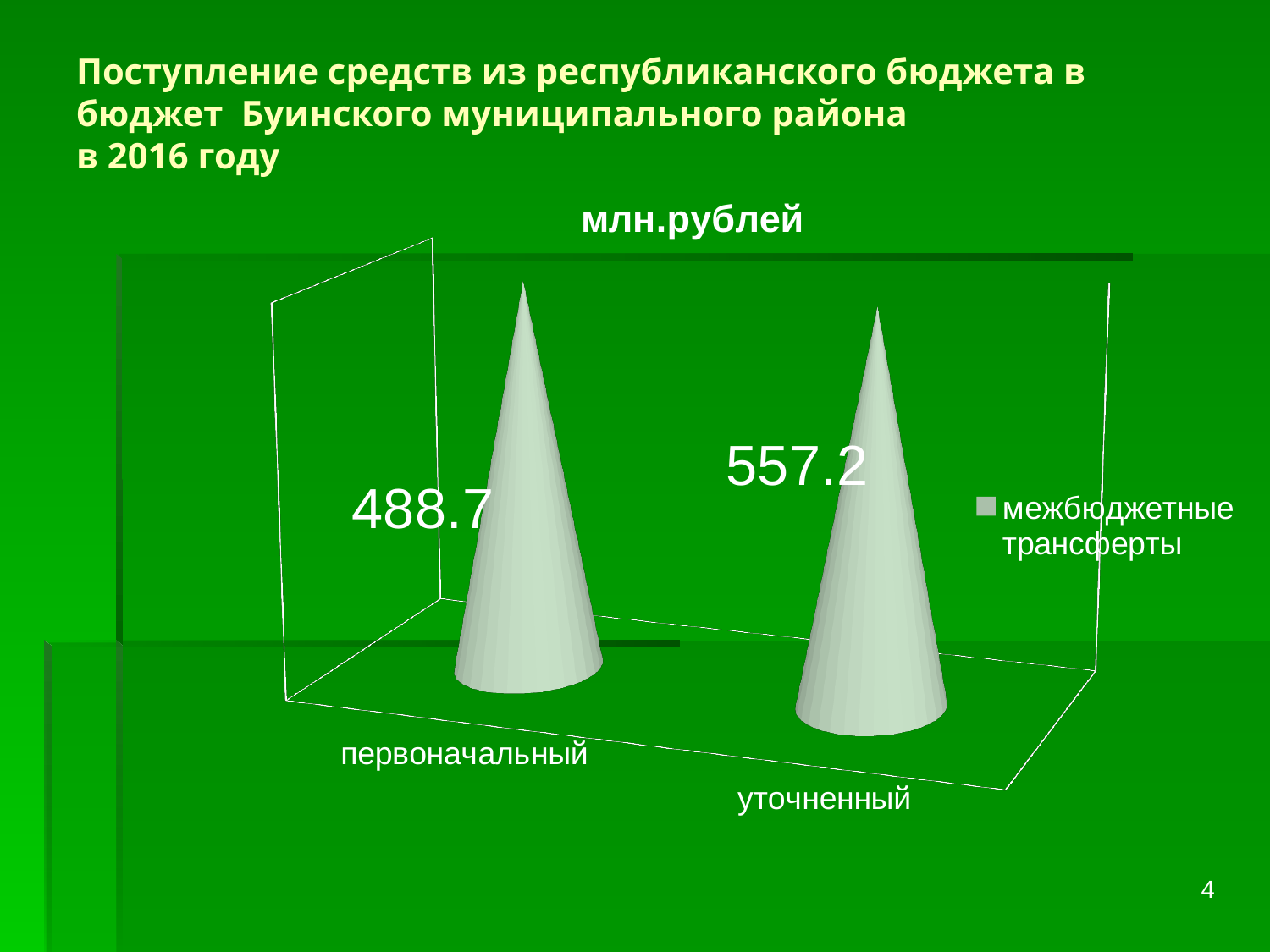
Which category has the lowest value? первоначальный How many series does the legend list? 1 Which is larger, the value for первоначальный or the value for уточненный? уточненный Which category has the highest value? уточненный What is the value for первоначальный? 488.7 What is the title of the chart? млн.рублей What kind of chart is shown on the slide? bar chart How many categories are shown on the chart? 2 Do the values rise or fall from первоначальный to уточненный? rise What is the difference between the values for уточненный and первоначальный? 68.5 What series name is listed in the legend? межбюджетные трансферты What is the value for уточненный? 557.2